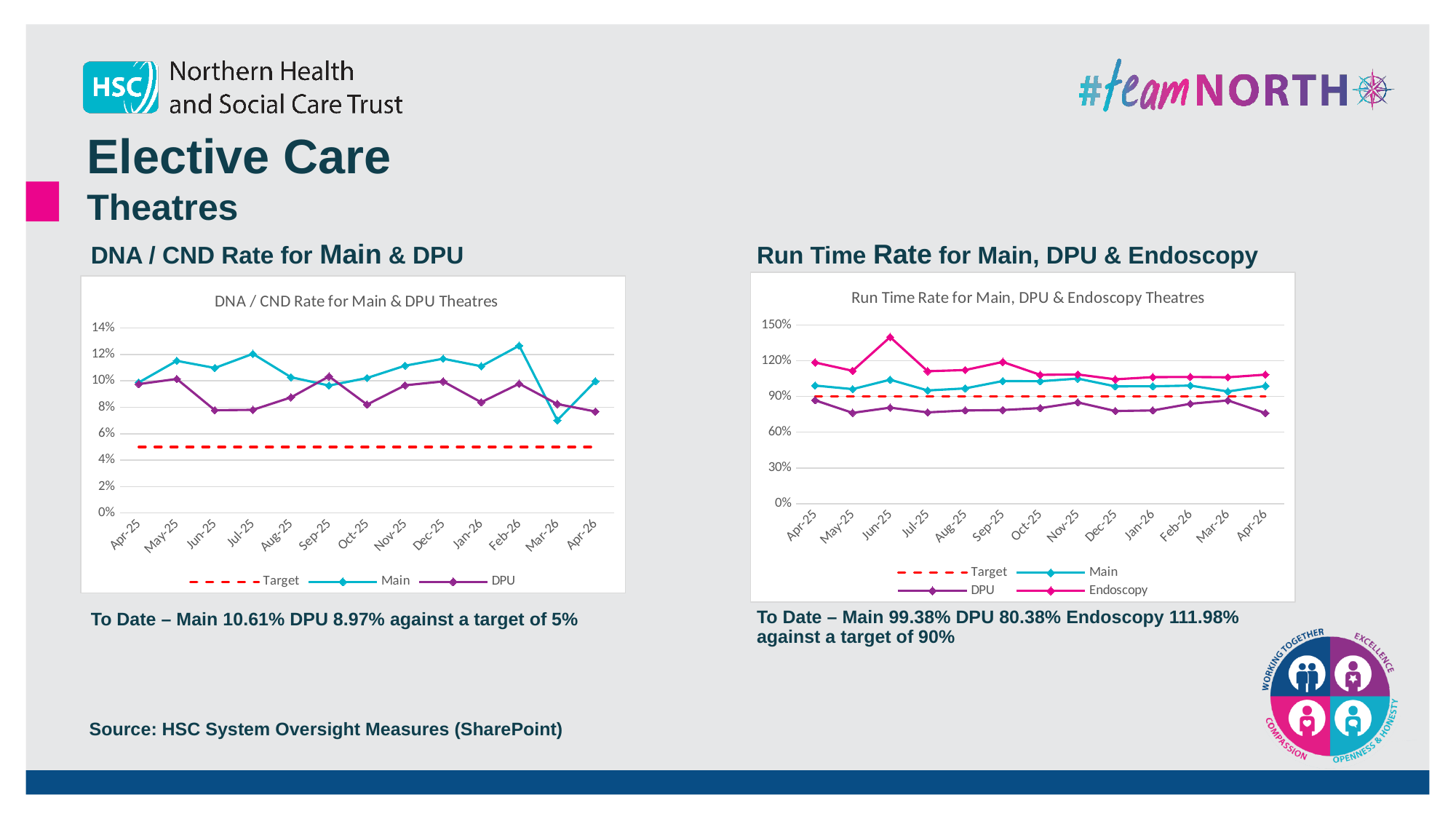
How many series does the legend of the 'Run Time Rate for Main, DPU & Endoscopy Theatres' chart list? 4 How many months are plotted along the x axis of the 'DNA / CND Rate for Main & DPU Theatres' chart? 13 In the 'DNA / CND Rate for Main & DPU Theatres' chart, is the Main value for Feb-26 greater or less than 12%? greater In the 'Run Time Rate for Main, DPU & Endoscopy Theatres' chart, in which month is the Endoscopy series highest? Jun-25 In the 'Run Time Rate for Main, DPU & Endoscopy Theatres' chart, which series is larger in Jun-25, Endoscopy or DPU? Endoscopy In the 'Run Time Rate for Main, DPU & Endoscopy Theatres' chart, is the DPU value for Apr-26 greater or less than 90%? less How many series does the legend of the 'DNA / CND Rate for Main & DPU Theatres' chart list? 3 In the 'DNA / CND Rate for Main & DPU Theatres' chart, in which month is the Main series highest? Feb-26 What kind of chart is the 'DNA / CND Rate for Main & DPU Theatres' chart? line chart In the 'DNA / CND Rate for Main & DPU Theatres' chart, in which month is the Main series lowest? Mar-26 In the 'Run Time Rate for Main, DPU & Endoscopy Theatres' chart, is the Endoscopy value for Jun-25 greater or less than 120%? greater